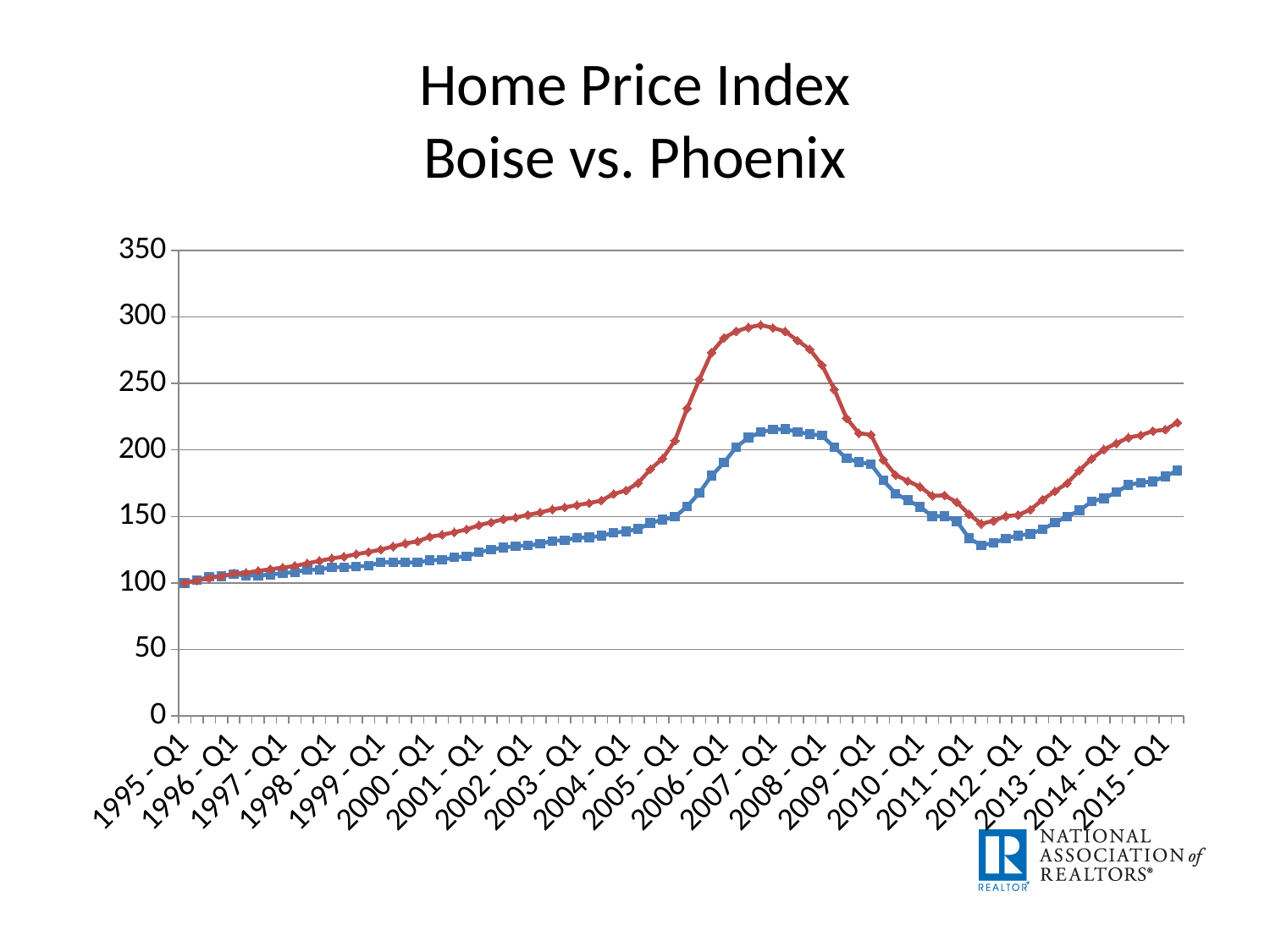
Is the value of the red line at 2015 - Q1 greater or less than 200? greater What is the value of both lines at 1995 - Q1? 100 Between 2007 - Q1 and 2012 - Q1, do the values of the red line rise or fall? fall Is the value of the blue line at 2015 - Q1 greater or less than 200? less What is the title of the chart? Home Price Index Boise vs. Phoenix Between 2012 - Q1 and 2015 - Q1, do the values of the blue line rise or fall? rise Is the value of the blue line at 2012 - Q1 greater or less than 150? less How many year labels are shown on the x axis? 21 Which line is higher at 2007 - Q1, the red line or the blue line? red line What kind of chart is shown on the slide? line chart